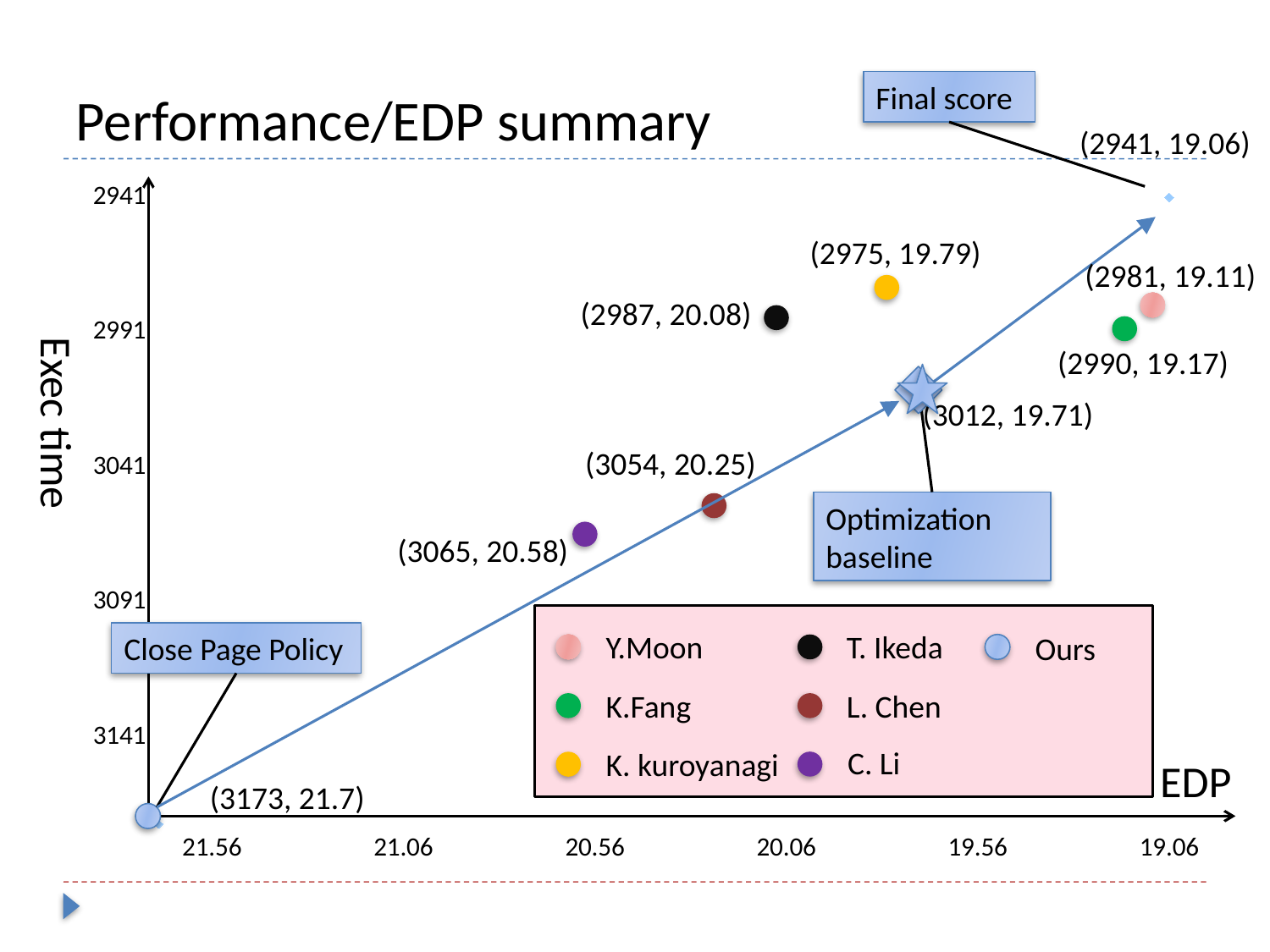
What are the coordinates labeled for the Close Page Policy point? (3173, 21.7) What are the coordinates labeled for the T. Ikeda point? (2987, 20.08) Which point has the lower EDP value, Y.Moon or K.Fang? Y.Moon What is the label of the horizontal axis? EDP What are the coordinates labeled for the Optimization baseline point? (3012, 19.71) What are the coordinates labeled for the Final score point? (2941, 19.06) How many entries does the legend list? 7 What is the difference in EDP between the Close Page Policy point (21.7) and the Final score point (19.06)? 2.64 Which labeled point has the highest Exec time value? Close Page Policy (3173, 21.7) What kind of chart is shown on the slide? scatter chart What are the coordinates labeled for the C. Li point? (3065, 20.58) What are the coordinates labeled for the K. kuroyanagi point? (2975, 19.79)